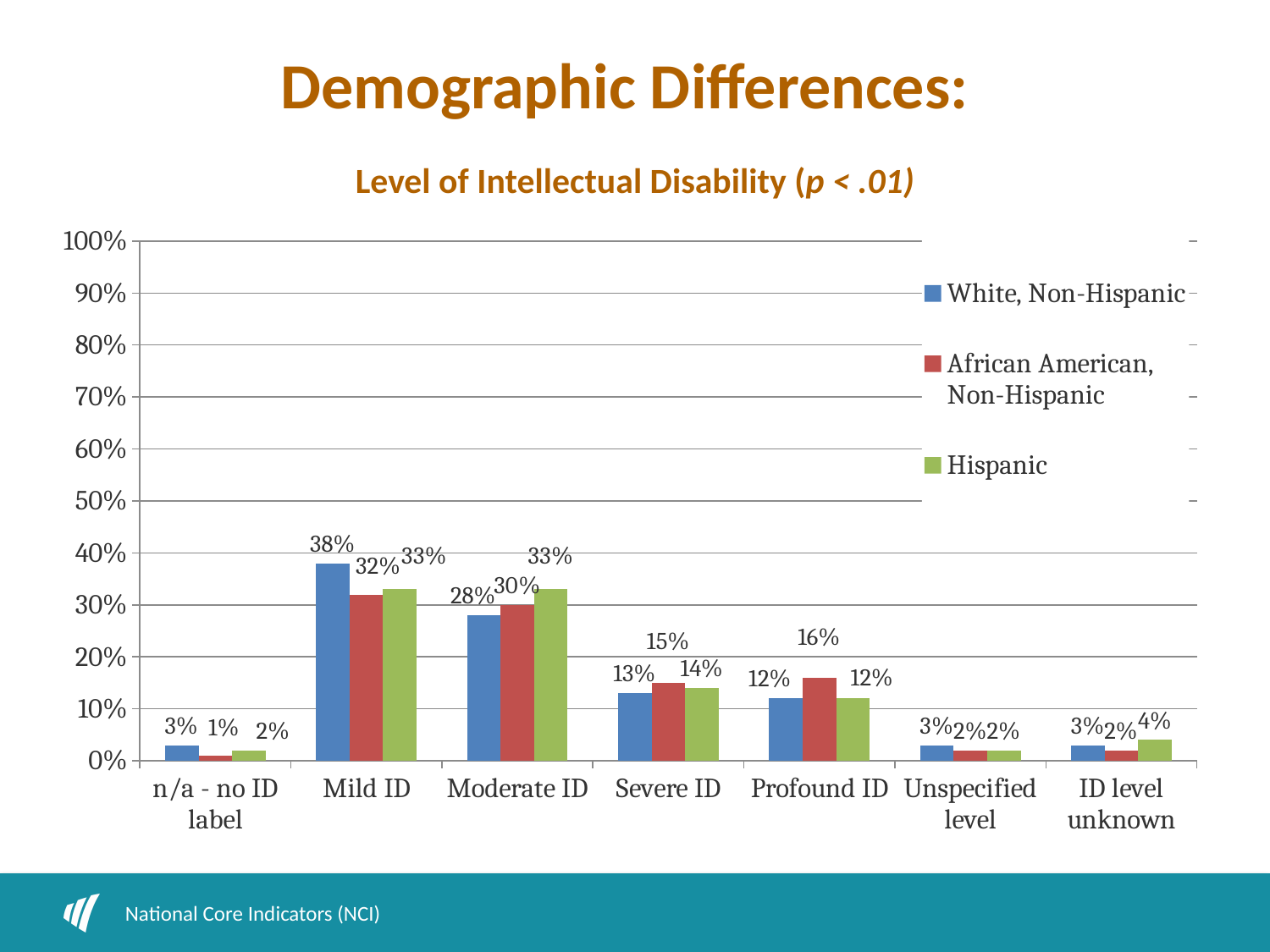
How many series does the legend list? 3 Which category has the lowest value for African American, Non-Hispanic? n/a - no ID label What kind of chart is shown on the slide? Bar chart What is the value for Hispanic in the Moderate ID category? 33% What is the value for African American, Non-Hispanic in the Profound ID category? 16% Which category has the highest value for White, Non-Hispanic? Mild ID What is the difference between the White, Non-Hispanic and African American, Non-Hispanic values in the Mild ID category? 6% How many categories are shown on the x axis? 7 In the Severe ID category, which is larger: the White, Non-Hispanic value or the African American, Non-Hispanic value? African American, Non-Hispanic What is the value for White, Non-Hispanic in the Mild ID category? 38% Is the value for Hispanic in the Mild ID category greater or less than 30%? greater What is the title of the chart? Level of Intellectual Disability (p < .01)